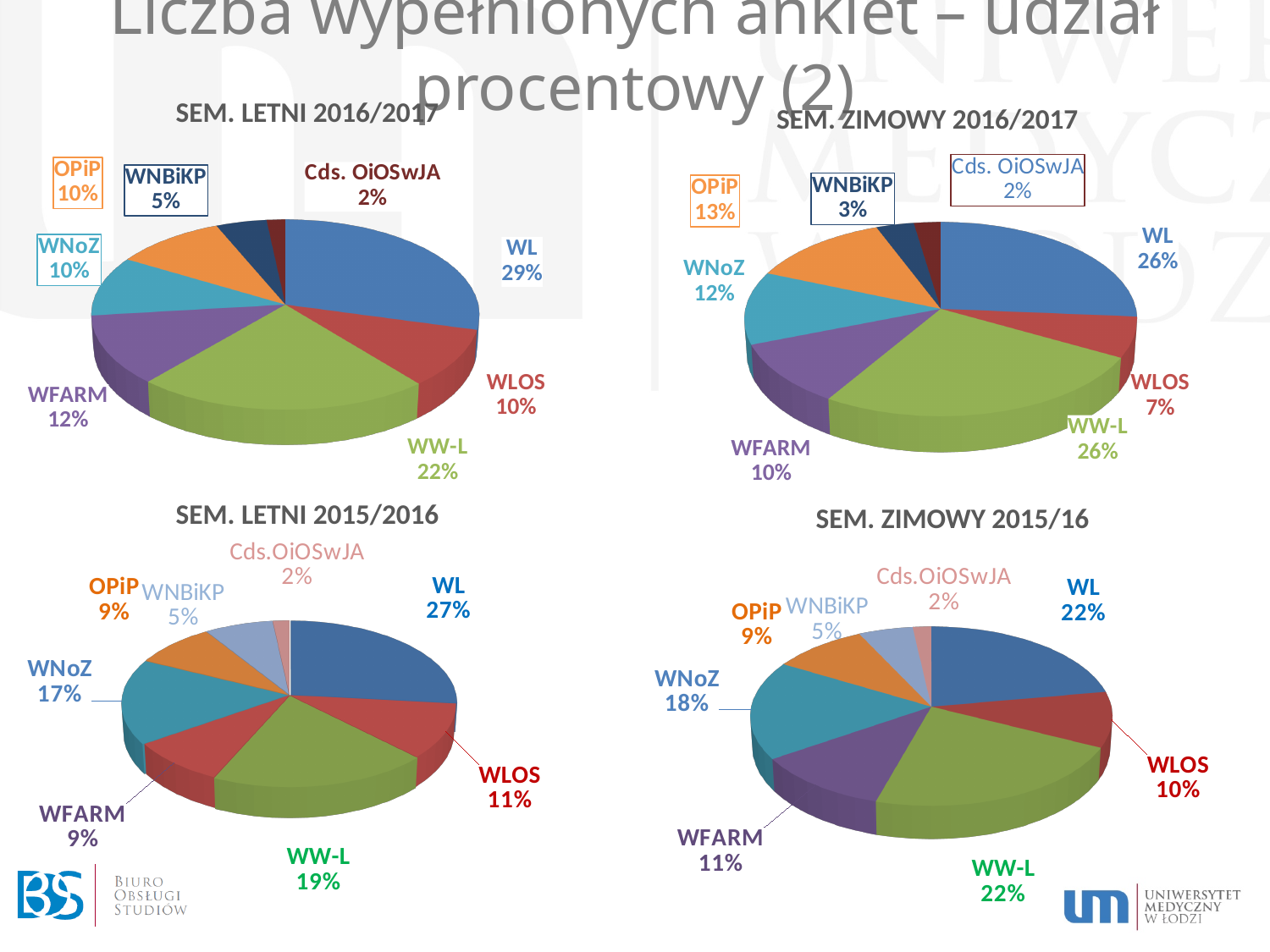
In the SEM. LETNI 2015/2016 chart, what share does WNoZ have? 17% In the SEM. LETNI 2016/2017 chart, what share does WL have? 29% In the SEM. ZIMOWY 2016/2017 chart, what is the difference between the shares of WNoZ and WLOS? 5% How many categories are shown in the SEM. LETNI 2016/2017 chart? 8 In the SEM. ZIMOWY 2016/2017 chart, what share does OPiP have? 13% In the SEM. ZIMOWY 2015/16 chart, what share does WFARM have? 11% In the SEM. LETNI 2015/2016 chart, what is the difference between the shares of WL and WW-L? 8% In the SEM. ZIMOWY 2015/16 chart, which is larger, the share of WNoZ or the share of WLOS? WNoZ In the SEM. LETNI 2016/2017 chart, which category has the largest share? WL What kind of chart is the SEM. ZIMOWY 2015/16 chart? Pie chart How many charts are on the slide? 4 In the SEM. LETNI 2015/2016 chart, which category has the smallest share? Cds.OiOSwJA